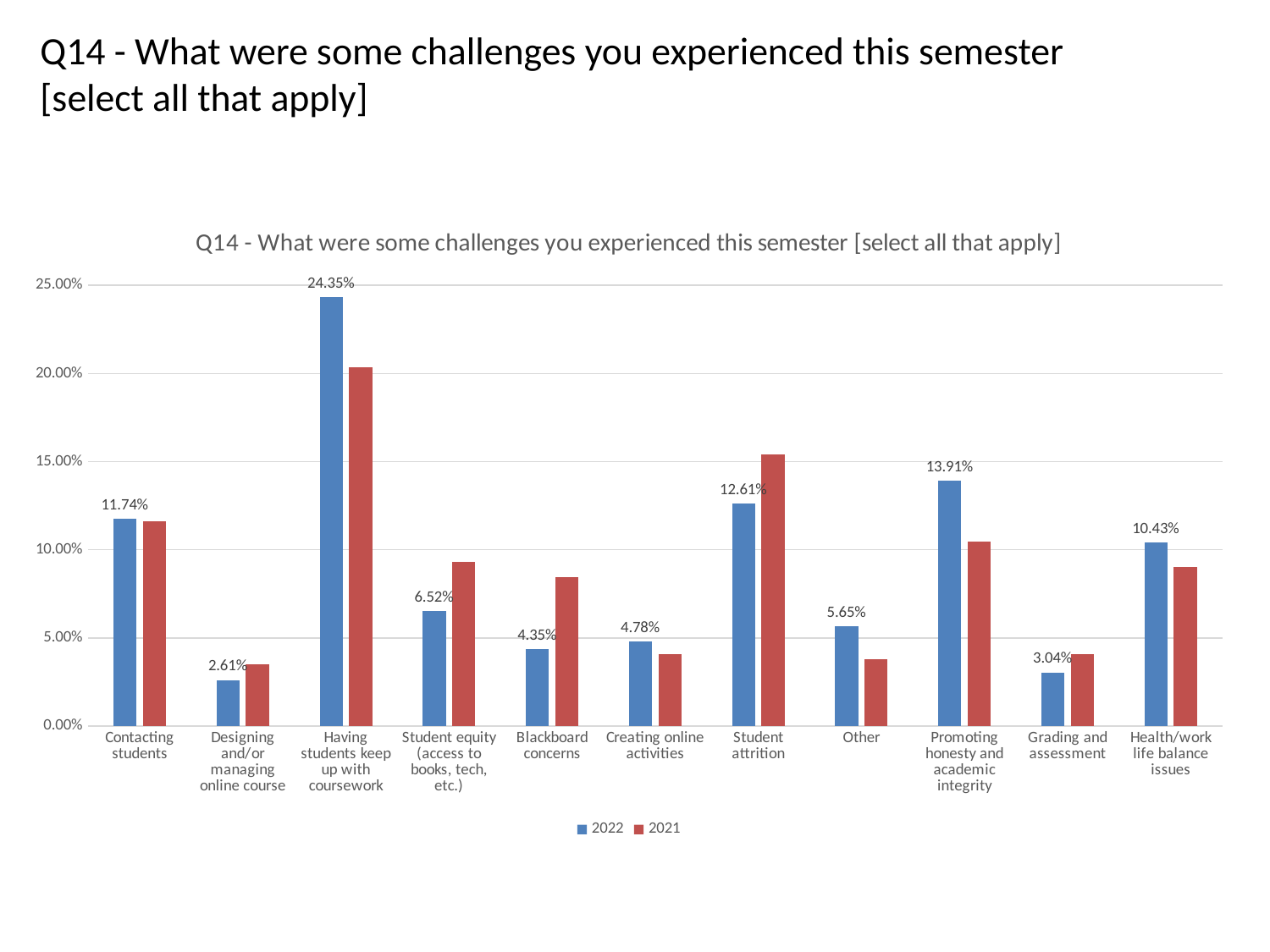
What is the 2022 value for Promoting honesty and academic integrity? 13.91% Which category has the highest 2022 value? Having students keep up with coursework What kind of chart is shown on the slide? Bar chart How many categories are shown on the x axis? 11 How many series does the legend list? 2 Is the 2021 value for Blackboard concerns greater or less than 10.00%? less What is the 2022 value for Having students keep up with coursework? 24.35% What is the 2022 value for Health/work life balance issues? 10.43% Which category has the lowest 2022 value? Designing and/or managing online course What is the difference between the 2022 values for Student attrition and Contacting students? 0.87% For Student attrition, which series has the larger value, 2022 or 2021? 2021